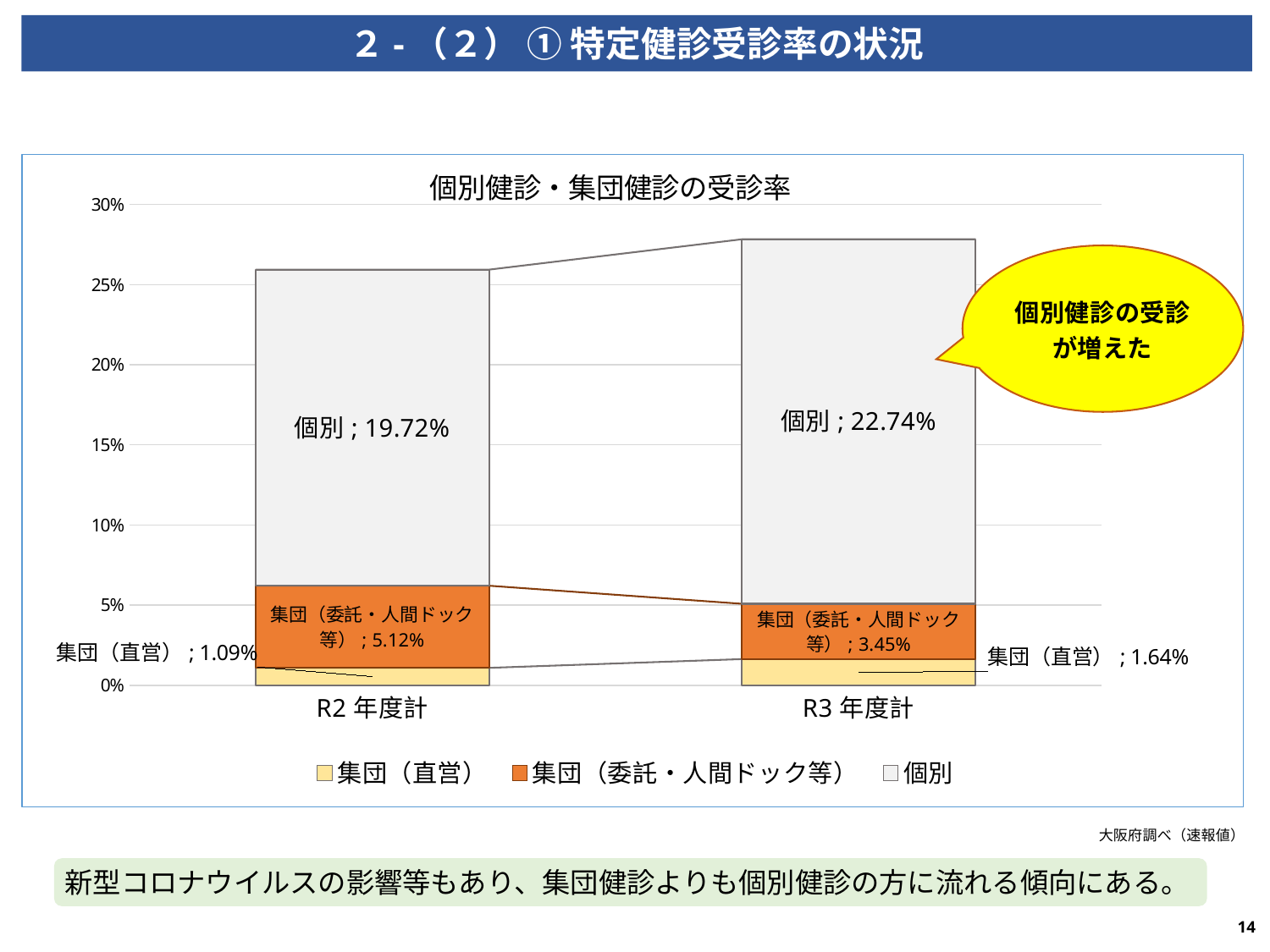
What is the value of 集団（直営） for R2 年度計? 1.09% What is the title of the chart? 個別健診・集団健診の受診率 What is the total of the stacked bar for R2 年度計? 25.93% By how many percentage points did 個別 increase from R2 年度計 to R3 年度計? 3.02 percentage points What is the difference between 集団（委託・人間ドック等） in R2 年度計 and R3 年度計? 1.67 percentage points What kind of chart is shown? Stacked bar chart How many series does the legend list? 3 What is the value of 集団（委託・人間ドック等） for R3 年度計? 3.45% Which is larger, 集団（直営） in R2 年度計 or in R3 年度計? R3 年度計 What is the value of 個別 for R2 年度計? 19.72% What is the value of 個別 for R3 年度計? 22.74% What is the total of the stacked bar for R3 年度計? 27.83%